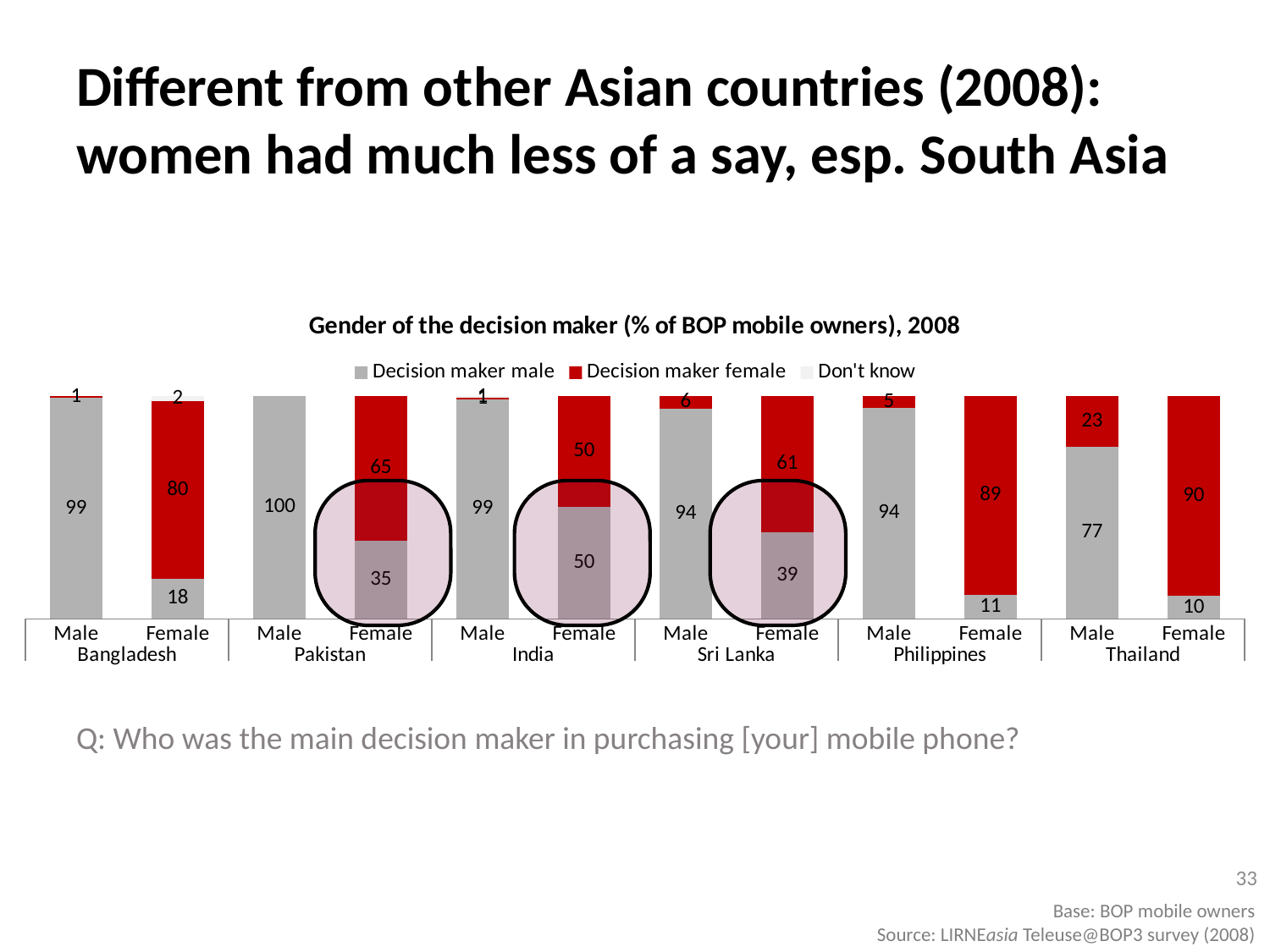
Among Female mobile owners, which country has the lowest 'Decision maker female' value? India What is the 'Decision maker male' value for Male mobile owners in Pakistan? 100 Which is larger: the 'Decision maker male' value for Female owners in Sri Lanka or in Pakistan? Sri Lanka What is the 'Decision maker female' value for Male mobile owners in Thailand? 23 What is the title of the chart? Gender of the decision maker (% of BOP mobile owners), 2008 Among Female mobile owners, which country has the highest 'Decision maker female' value? Thailand What kind of chart is shown on the slide? Stacked bar chart How many bars are plotted in the chart? 12 What is the difference between the 'Decision maker female' values for Female owners in the Philippines and in Sri Lanka? 28 How many series does the legend list? 3 What is the 'Decision maker male' value for Female mobile owners in Bangladesh? 18 What is the 'Decision maker female' value for Female mobile owners in Pakistan? 65